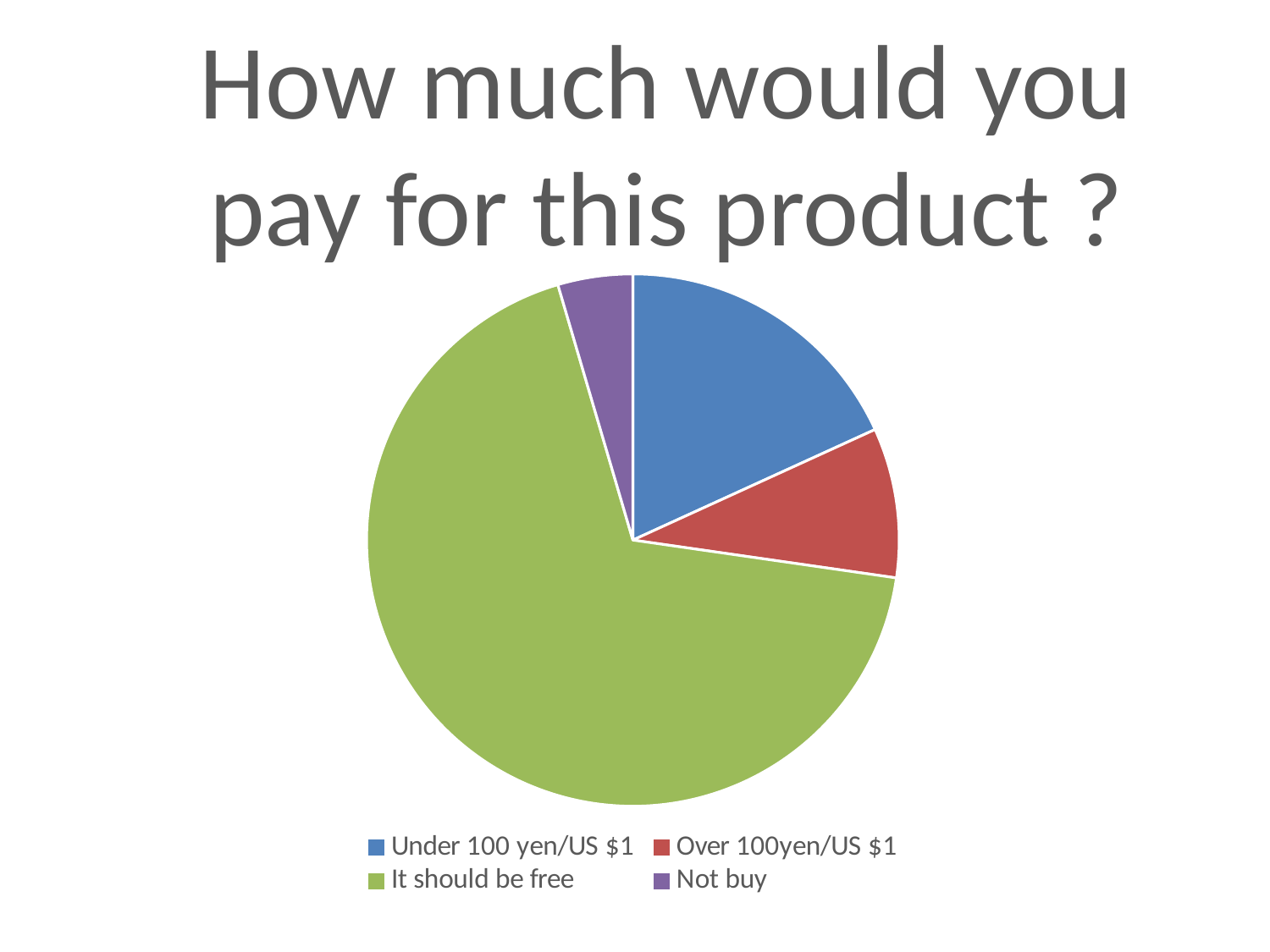
How many categories does the pie chart have? 4 Which category is shown in green in the pie chart? It should be free Which slice is larger, "Over 100yen/US $1" or "Not buy"? Over 100yen/US $1 Which slice is larger, "It should be free" or "Under 100 yen/US $1"? It should be free Which slice is larger, "Under 100 yen/US $1" or "Over 100yen/US $1"? Under 100 yen/US $1 Which category has the smallest slice of the pie? Not buy What kind of chart is shown on the slide? Pie chart Which category has the largest slice of the pie? It should be free What is the title of the chart on the slide? How much would you pay for this product ?